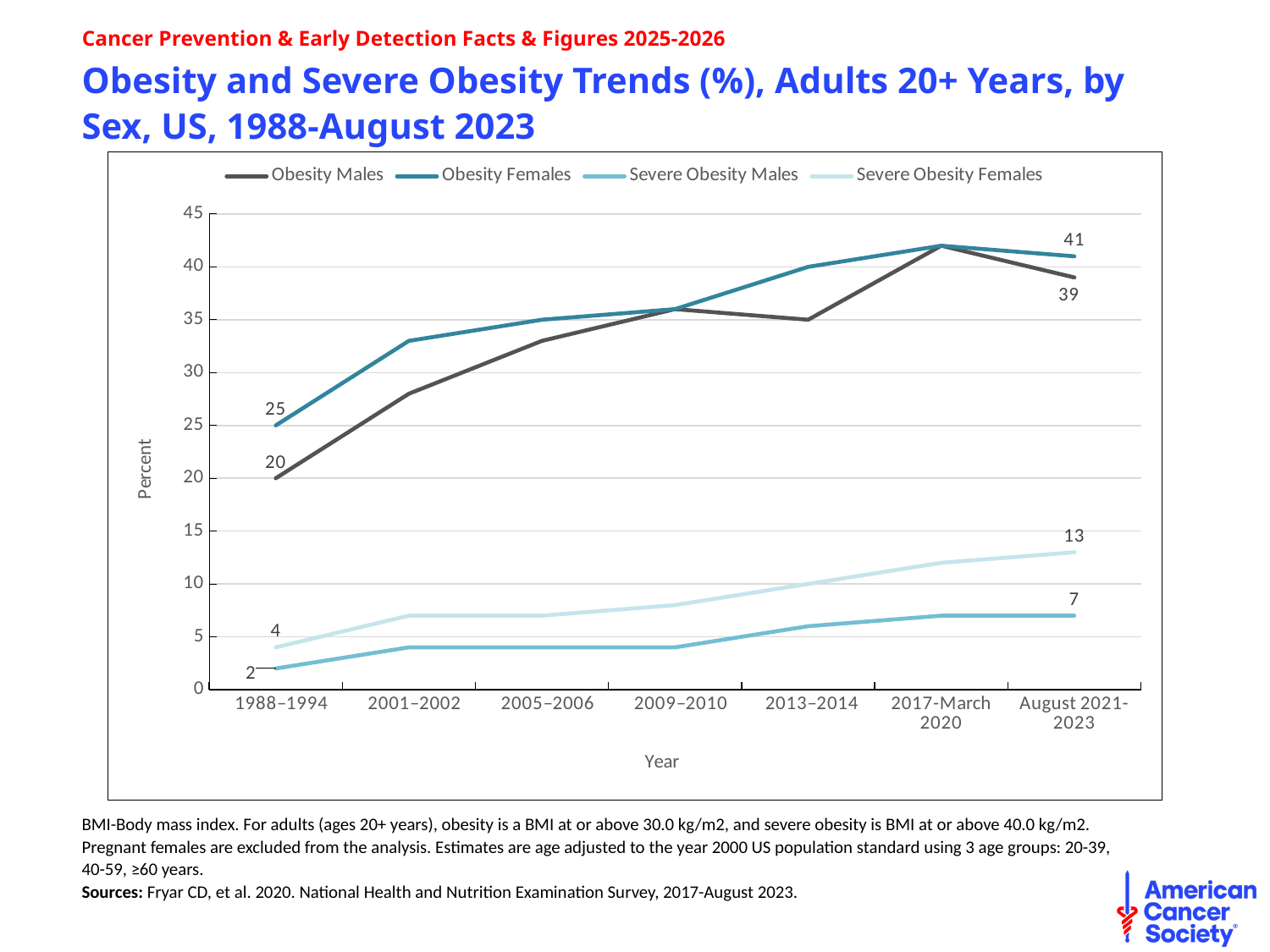
What is the value for Severe Obesity Females in August 2021-2023? 13 What is the value for Obesity Males in 1988–1994? 20 By how much did Severe Obesity Females increase from 1988–1994 to August 2021-2023? 9 How many series does the legend list? 4 Which series has the highest value in August 2021-2023? Obesity Females How many time periods are shown on the x axis? 7 What is the value for Severe Obesity Males in 1988–1994? 2 What is the difference between Obesity Females and Obesity Males in August 2021-2023? 2 Does the Severe Obesity Females line rise or fall from 1988–1994 to August 2021-2023? rise What is the value for Obesity Females in August 2021-2023? 41 Is the value for Obesity Females in 2013–2014 greater or less than 35? greater What type of chart is shown on the slide? line chart